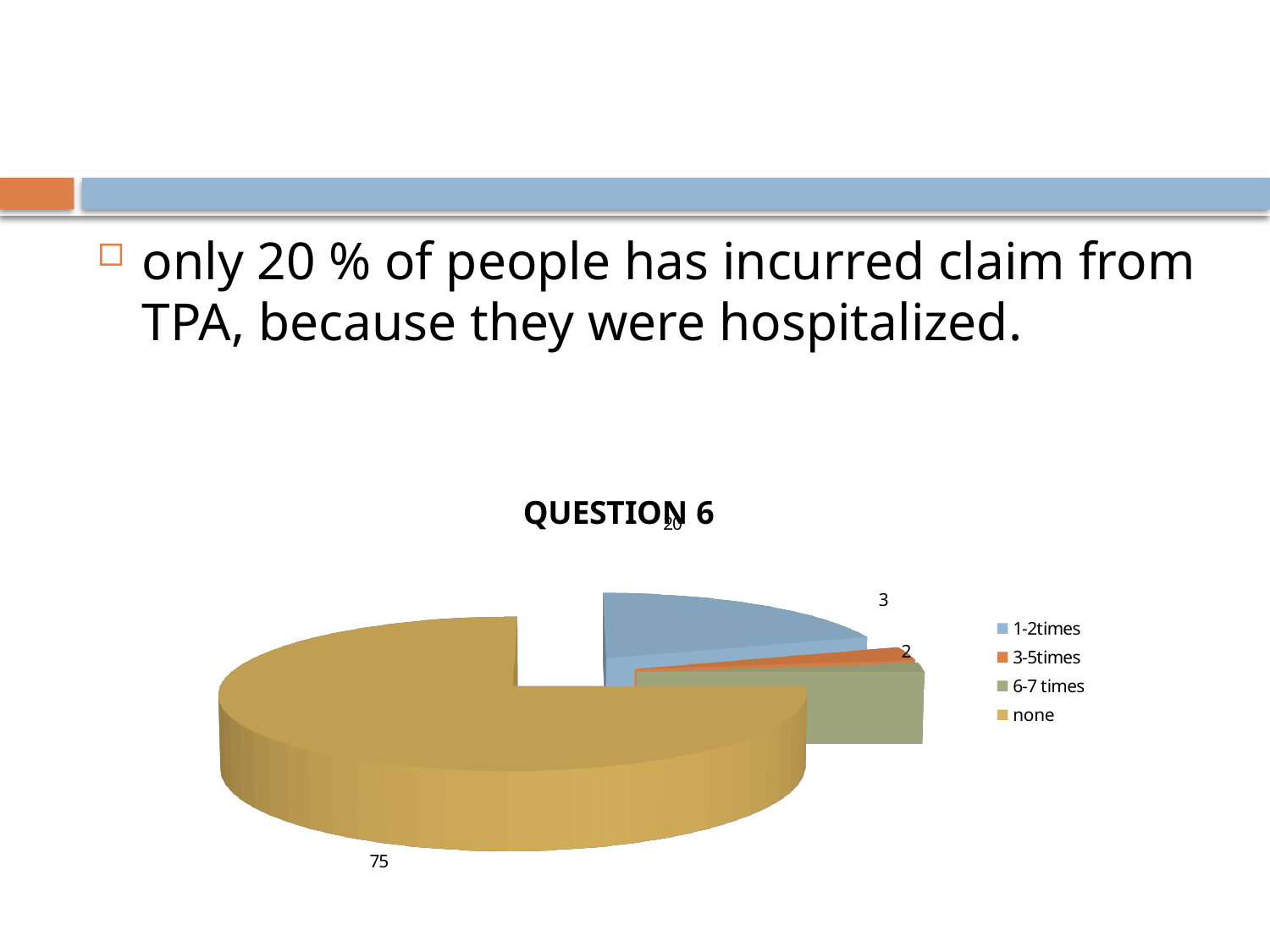
What is the difference between the 'none' value and the '1-2times' value? 55 What share of the pie does the '1-2times' slice represent? 20% What is the value shown for the '1-2times' slice? 20 What is the title of the chart? QUESTION 6 Which category has the largest slice of the pie? none What is the value shown for the 'none' slice? 75 Which is larger, the 'none' slice or the '1-2times' slice? none What kind of chart is shown on the slide? pie chart What share of the pie does the 'none' slice represent? 75% How many categories does the legend of the pie chart list? 4 Which legend entry is shown in blue? 1-2times